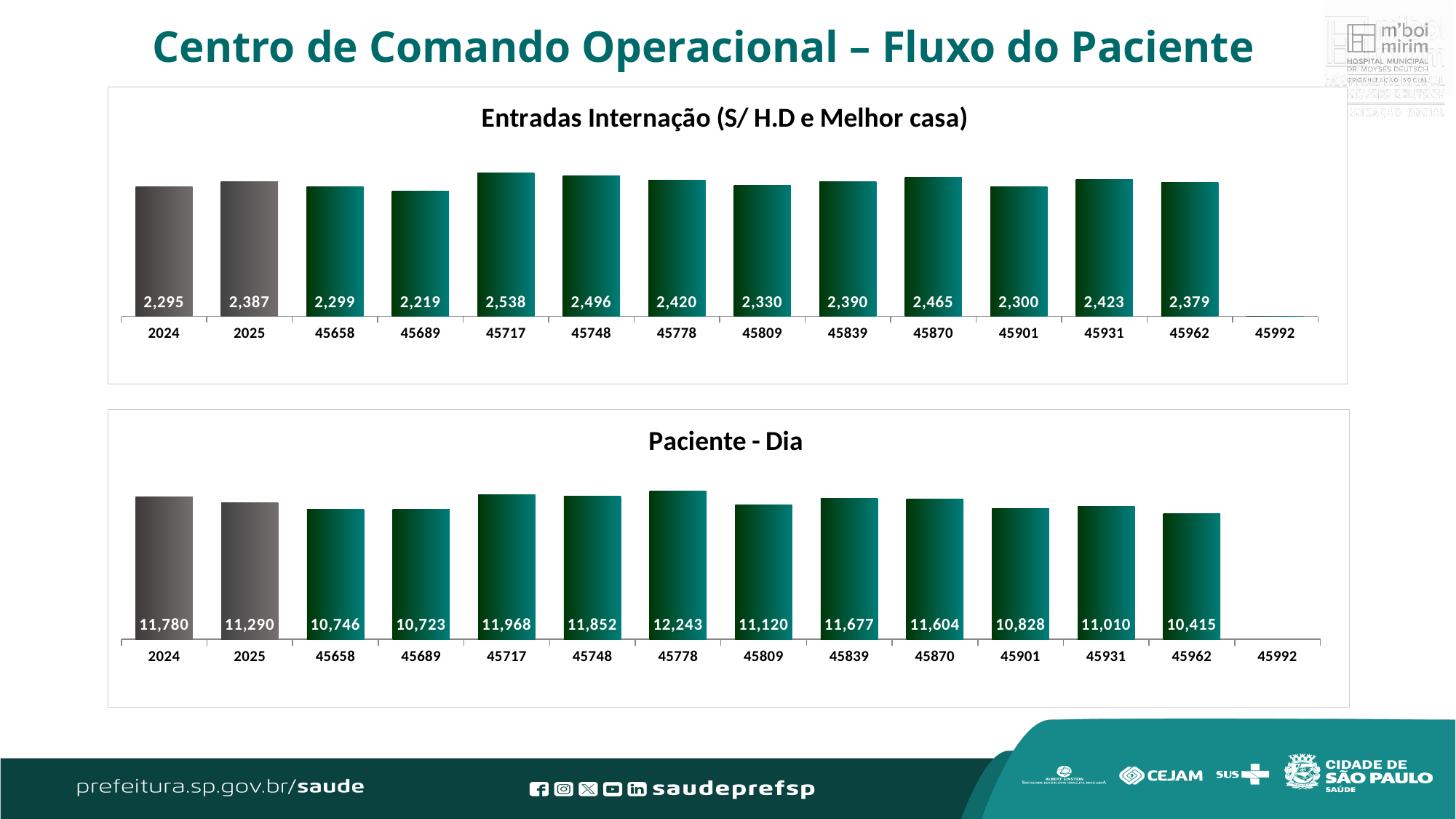
In the 'Entradas Internação (S/ H.D e Melhor casa)' chart, what is the value for 2025? 2,387 In the 'Entradas Internação (S/ H.D e Melhor casa)' chart, what is the difference between the values for 45717 and 45689? 319 In the 'Paciente - Dia' chart, which category has the lowest value? 45962 In the 'Entradas Internação (S/ H.D e Melhor casa)' chart, which is larger, the value for 2024 or the value for 45658? 45658 In the 'Paciente - Dia' chart, what is the value for 45839? 11,677 What type of chart is the 'Entradas Internação (S/ H.D e Melhor casa)' chart? Bar chart In the 'Paciente - Dia' chart, how many bars have a data label printed? 13 In the 'Entradas Internação (S/ H.D e Melhor casa)' chart, which category has the highest value? 45717 In the 'Paciente - Dia' chart, what is the difference between the values for 2024 and 2025? 490 In the 'Paciente - Dia' chart, which is larger, the value for 45717 or the value for 45748? 45717 In the 'Paciente - Dia' chart, which category has the highest value? 45778